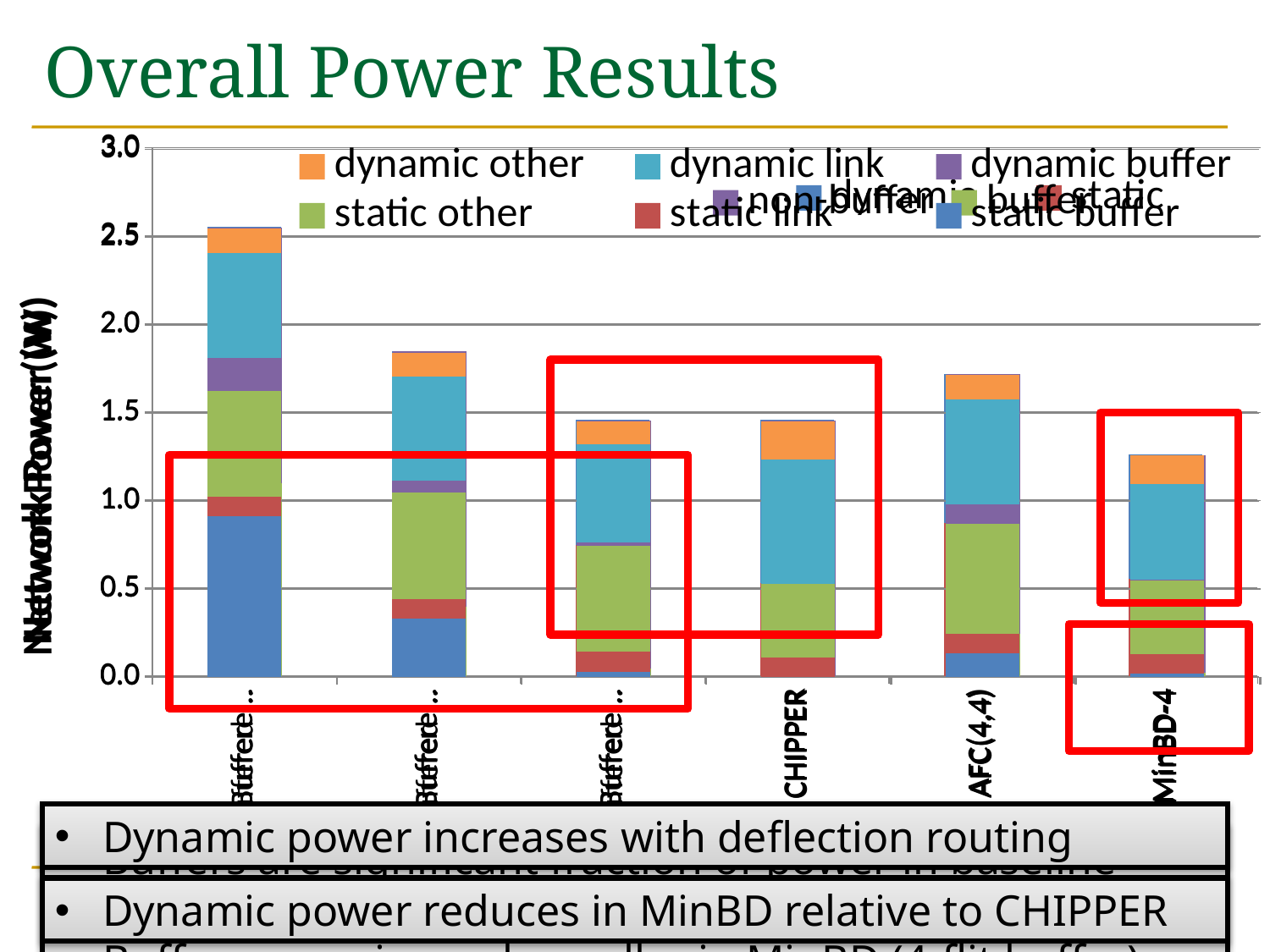
Among CHIPPER, AFC(4,4) and MinBD-4, which has the highest total network power? AFC(4,4) Is the total network power for AFC(4,4) greater or less than 1.5? greater Which has the larger total network power, AFC(4,4) or CHIPPER? AFC(4,4) Which has the larger total network power, CHIPPER or MinBD-4? CHIPPER Is the total network power for CHIPPER greater or less than 1.0? greater What colour represents the 'dynamic link' series in the legend? light blue What kind of chart is shown on the slide? stacked bar chart Among CHIPPER, AFC(4,4) and MinBD-4, which has the lowest total network power? MinBD-4 What is the label on the vertical axis of the chart? Network Power (W) Is the total network power of the leftmost bar greater or less than 2.0? greater How many bars (categories) are plotted in the chart? 6